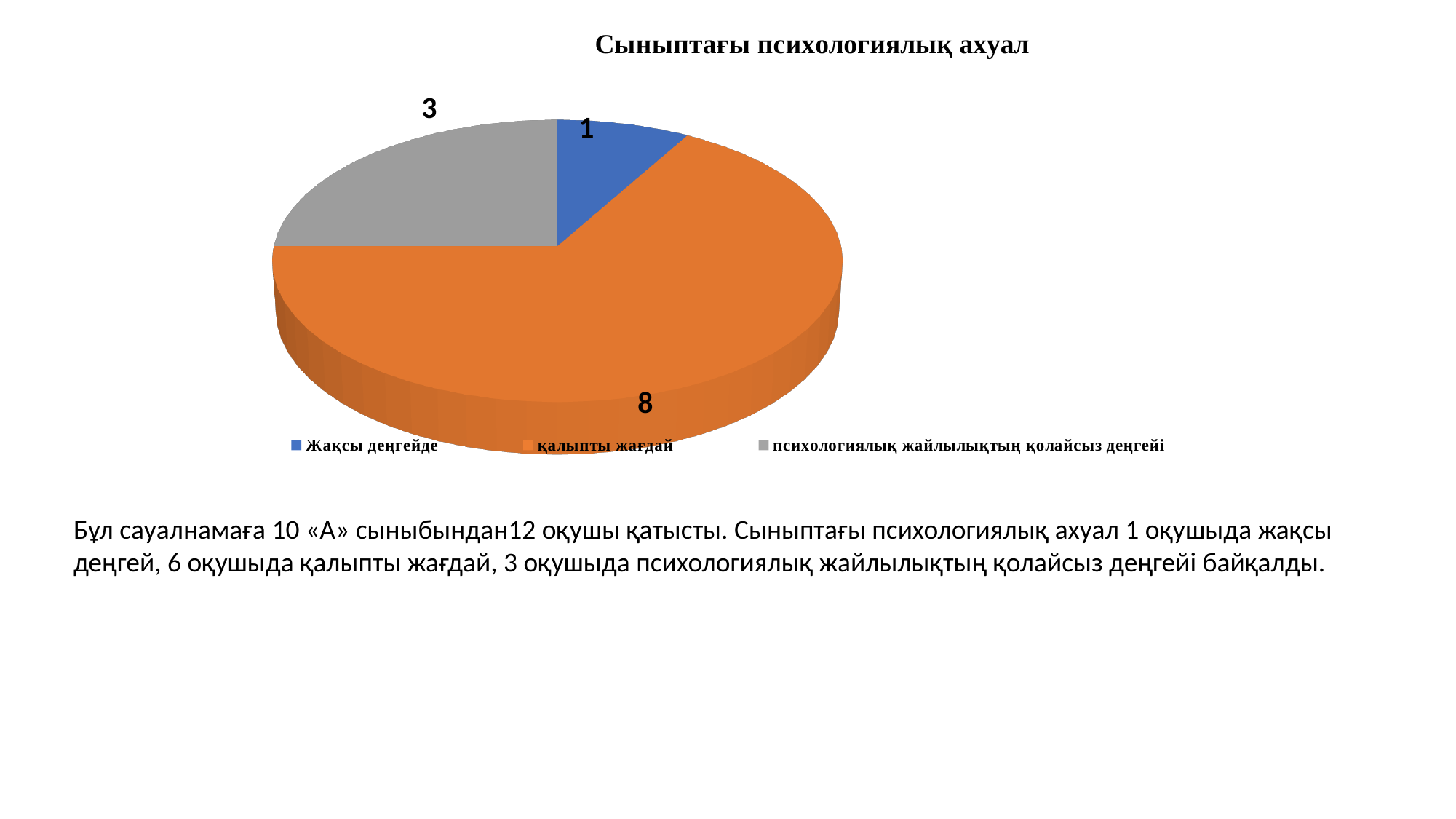
Which category has the smallest slice? Жақсы деңгейде What share of the pie does "психологиялық жайлылықтың қолайсыз деңгейі" represent? 25% Which category has the largest slice? қалыпты жағдай What is the value for "қалыпты жағдай"? 8 Which is larger, the value for "психологиялық жайлылықтың қолайсыз деңгейі" or the value for "Жақсы деңгейде"? психологиялық жайлылықтың қолайсыз деңгейі What is the value for "Жақсы деңгейде"? 1 How many slices does the pie chart have? 3 How many entries does the legend list? 3 What is the value for "психологиялық жайлылықтың қолайсыз деңгейі"? 3 What is the title of the chart? Сыныптағы психологиялық ахуал What is the difference between the values for "қалыпты жағдай" and "психологиялық жайлылықтың қолайсыз деңгейі"? 5 What kind of chart is shown on the slide? pie chart